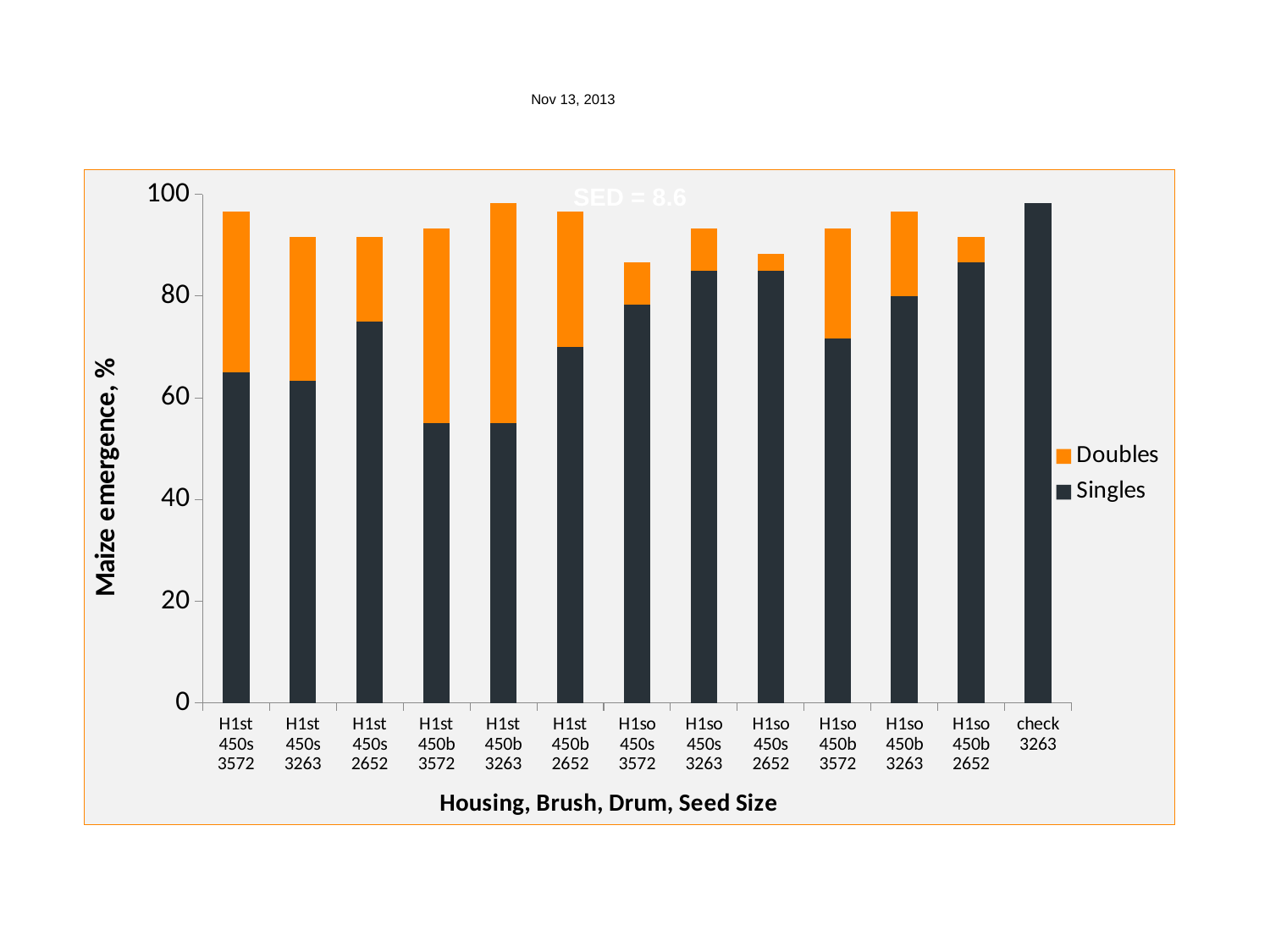
Which has the larger Doubles segment, H1st 450s 3572 or H1so 450s 3263? H1st 450s 3572 What is the title of the y axis? Maize emergence, % Which has the larger Singles value, H1st 450s 2652 or H1st 450s 3263? H1st 450s 2652 How many bars (categories) are plotted along the x axis? 13 Is the total bar height for check 3263 greater or less than 80? greater Which category has the highest Singles value? check 3263 Is the Singles value for H1st 450s 3572 greater or less than 60? greater How many series does the legend list? 2 Is the Singles value for H1st 450b 3572 greater or less than 60? less What is the title of the x axis? Housing, Brush, Drum, Seed Size What kind of chart is shown on the slide? Stacked bar chart